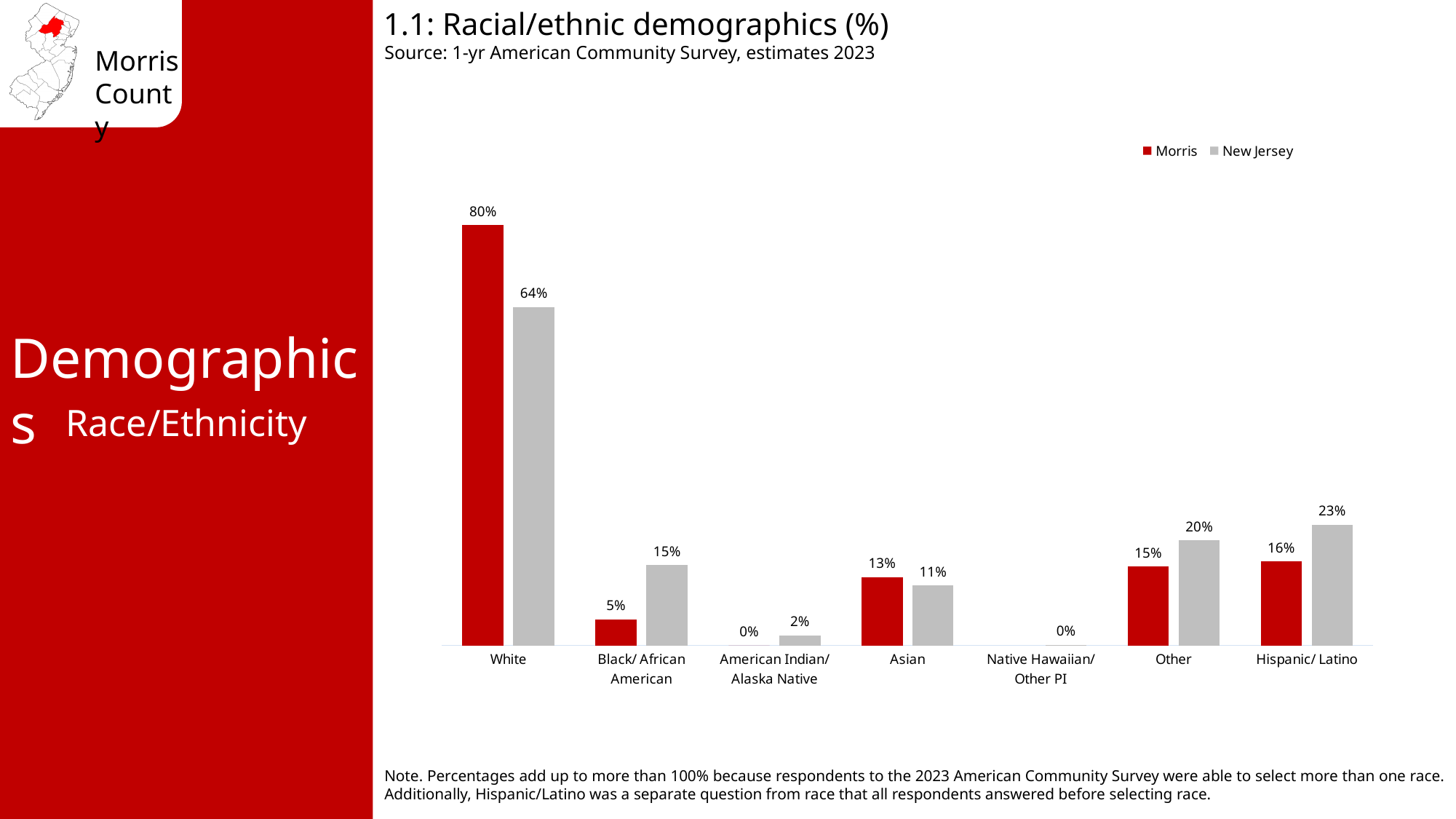
How many racial/ethnic categories are shown on the x axis? 7 What kind of chart is shown on the slide? Bar chart For Asian, which is larger: the Morris value or the New Jersey value? Morris What is the difference between the New Jersey and Morris values for Hispanic/ Latino? 7% What colour represents Morris in the chart? Red What is the New Jersey value for Hispanic/ Latino? 23% Which category has the highest Morris value? White What is the difference between the Morris and New Jersey values for White? 16% What is the Morris value for Other? 15% What is the Morris value for White? 80% What is the New Jersey value for Black/ African American? 15% How many series does the legend list? 2